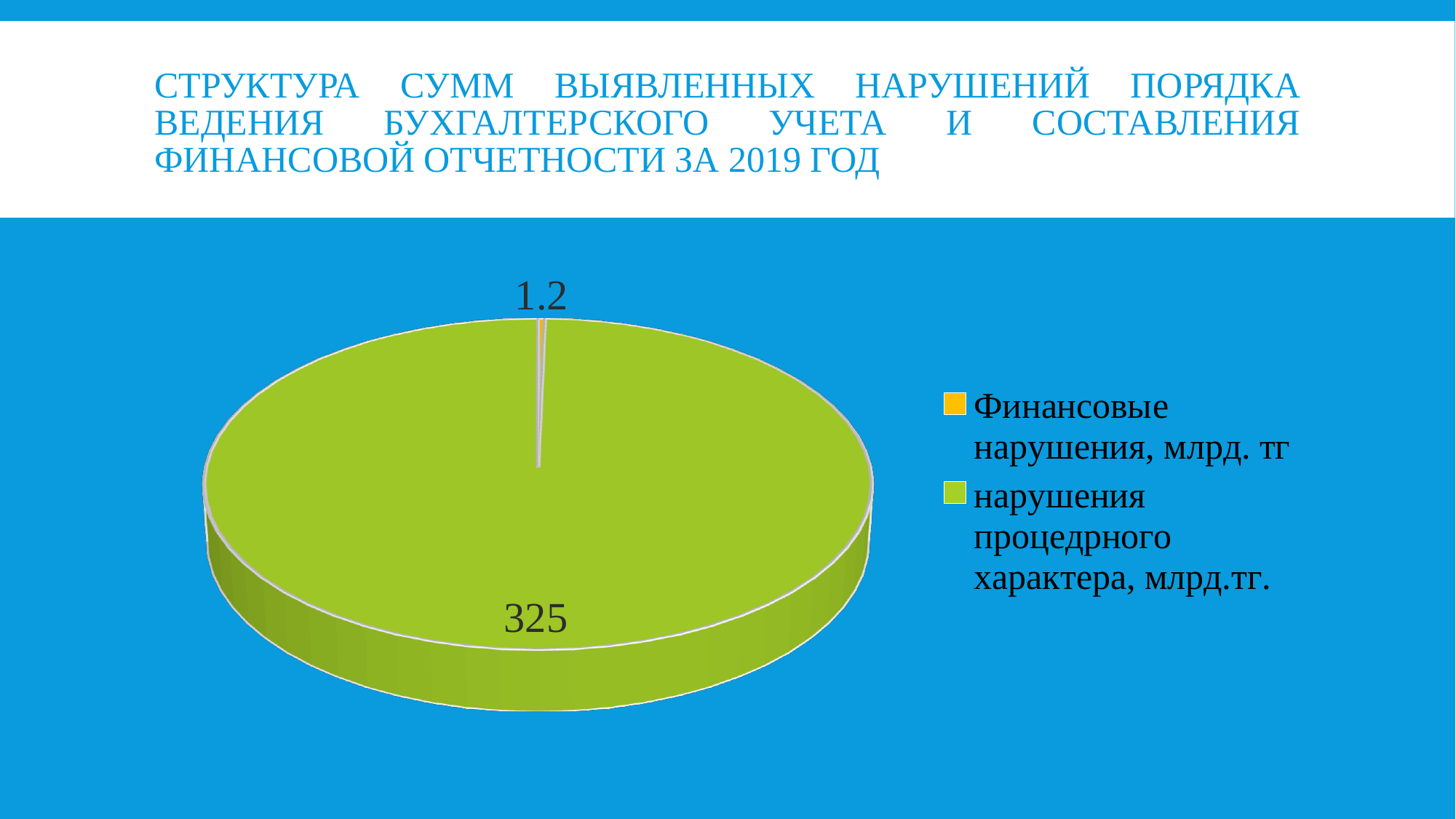
What kind of chart is shown on the slide? pie chart Which category has the smallest slice of the pie? Финансовые нарушения, млрд. тг What is the total of the two values shown on the pie chart? 326.2 What is the value for "Финансовые нарушения, млрд. тг"? 1.2 How many slices does the pie chart have? 2 How many entries does the legend list? 2 Which category has the largest slice of the pie? нарушения процедрного характера, млрд.тг. What colour does the legend use for "Финансовые нарушения, млрд. тг"? orange What colour is the slice for "нарушения процедрного характера, млрд.тг."? green Which is larger: the value for "Финансовые нарушения, млрд. тг" or the value for "нарушения процедрного характера, млрд.тг."? нарушения процедрного характера, млрд.тг. What is the difference between the value for "нарушения процедрного характера, млрд.тг." and the value for "Финансовые нарушения, млрд. тг"? 323.8 What is the value for "нарушения процедрного характера, млрд.тг."? 325